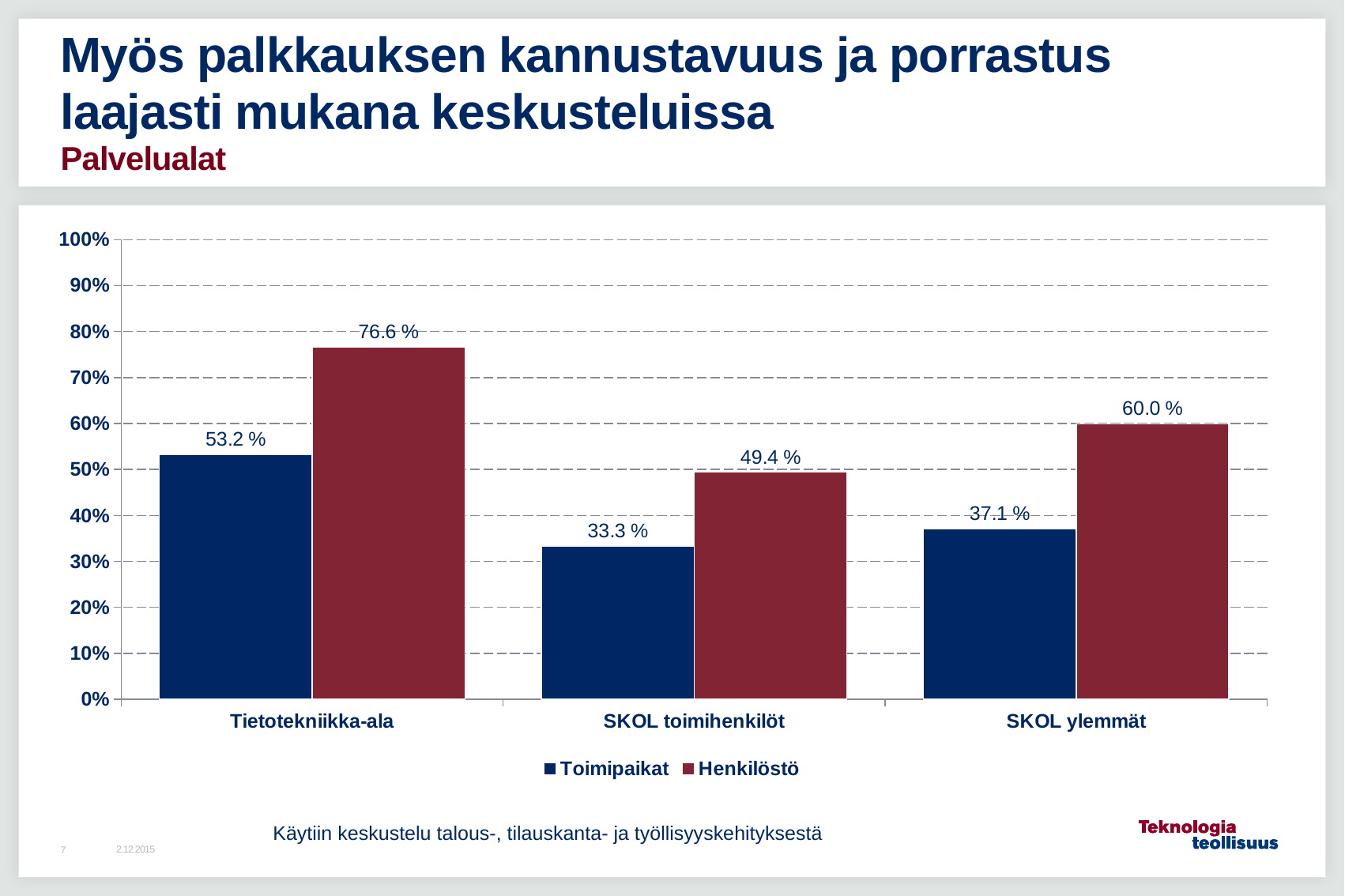
What is the Henkilöstö value for SKOL ylemmät? 60.0 % Is the Toimipaikat value for SKOL ylemmät greater or less than 40%? less What kind of chart is shown on the slide? bar chart What is the Henkilöstö value for SKOL toimihenkilöt? 49.4 % How many series does the legend list? 2 Which is larger for SKOL toimihenkilöt, Toimipaikat or Henkilöstö? Henkilöstö What is the difference between the Henkilöstö and Toimipaikat values for Tietotekniikka-ala? 23.4 % What is the difference between the Henkilöstö and Toimipaikat values for SKOL ylemmät? 22.9 % How many categories are shown on the x axis? 3 Which category has the lowest Toimipaikat value? SKOL toimihenkilöt What is the Toimipaikat value for Tietotekniikka-ala? 53.2 % Which category has the highest Henkilöstö value? Tietotekniikka-ala